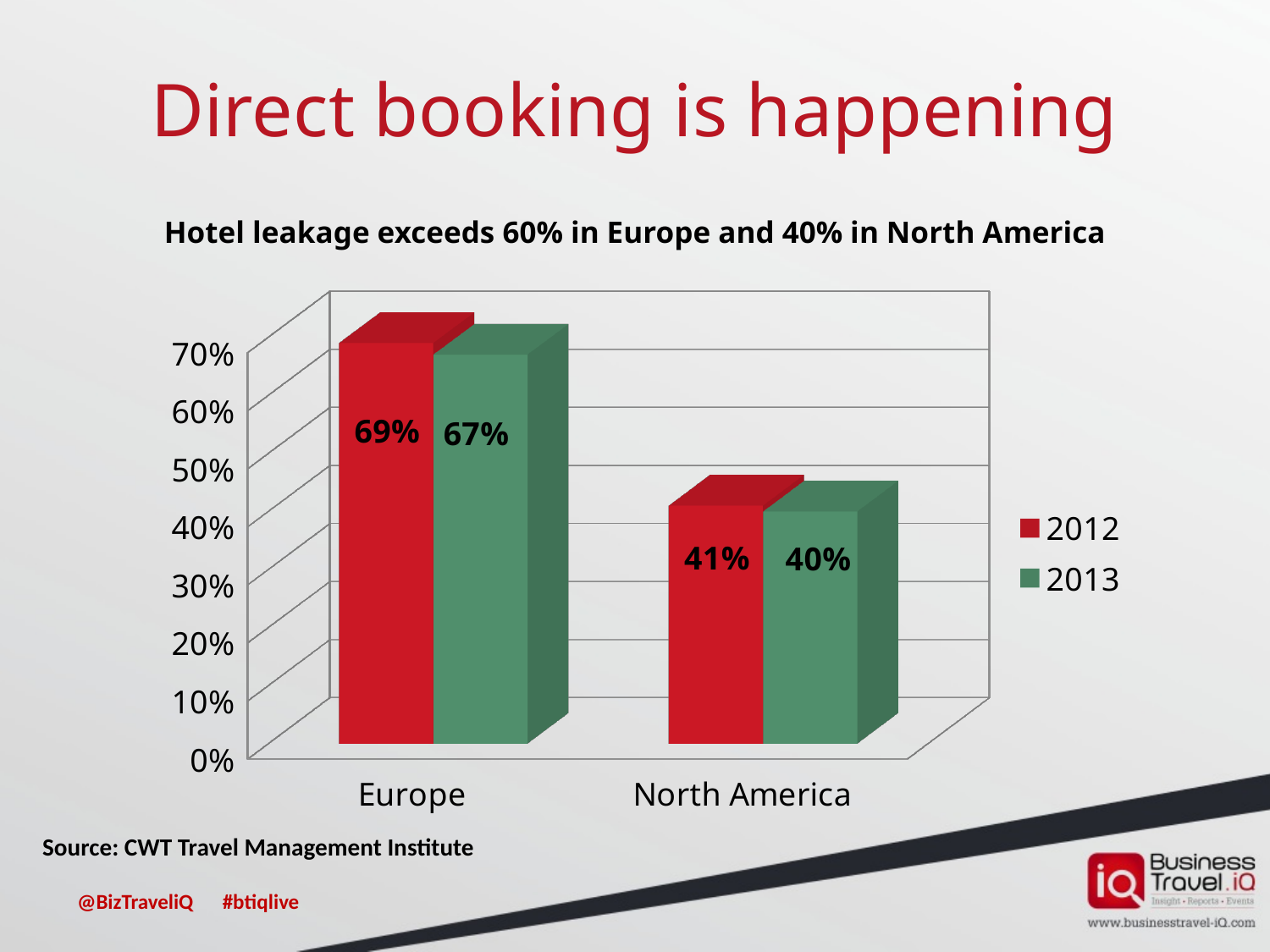
What is the difference between the 2012 and 2013 values for Europe? 2% How many series does the legend list? 2 What kind of chart is shown on the slide? Bar chart What is the hotel leakage value for Europe in 2013? 67% What is the hotel leakage value for Europe in 2012? 69% Which region has the lowest hotel leakage in 2013? North America How many regions are shown on the x axis? 2 What is the hotel leakage value for North America in 2013? 40% Which is larger, the 2012 value for Europe or the 2012 value for North America? Europe Which region has the highest hotel leakage in 2012? Europe What is the hotel leakage value for North America in 2012? 41% What is the difference between the Europe and North America values in 2013? 27%